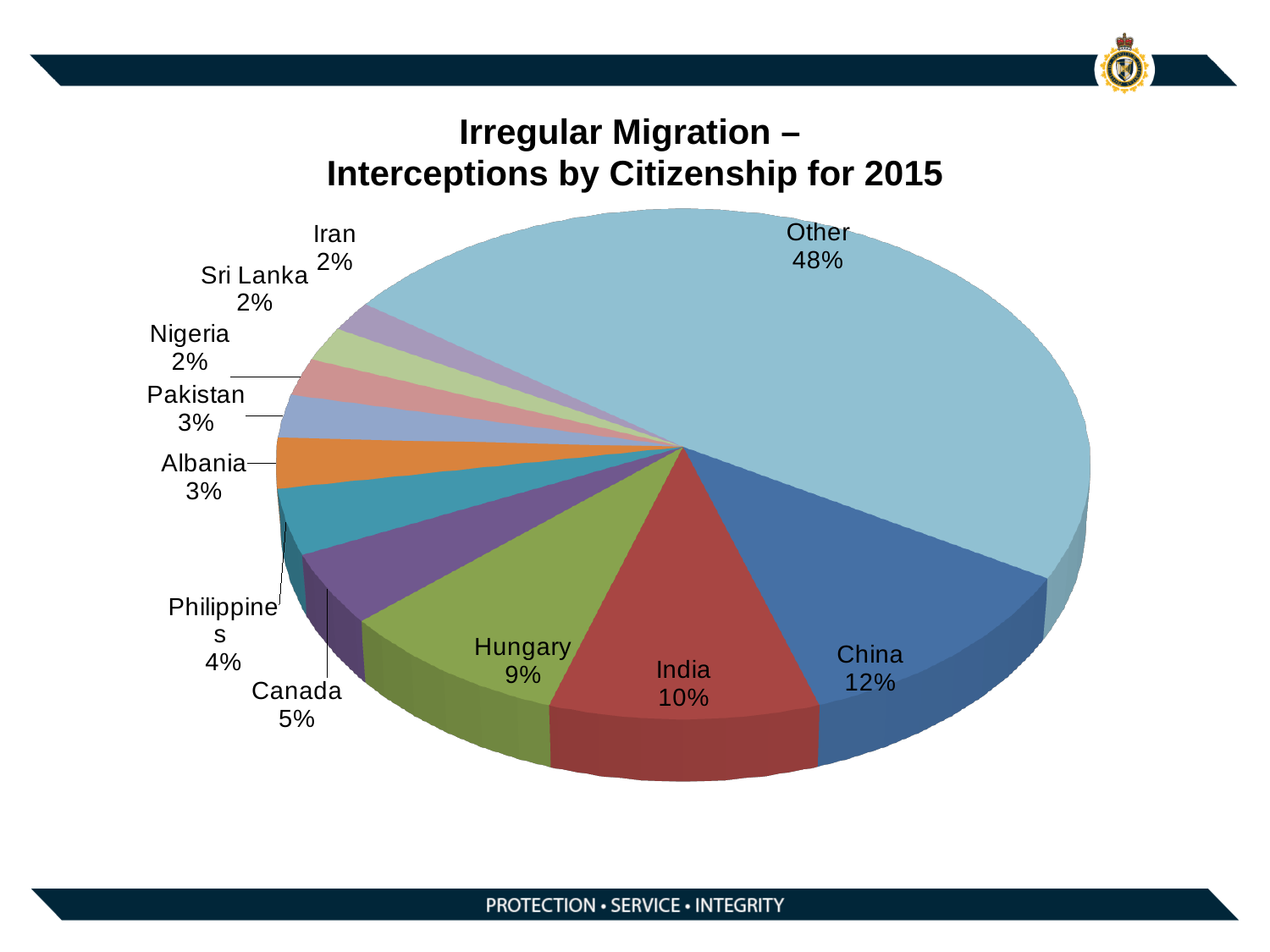
What is the difference in percentage points between China and India? 2 What percentage is shown for Albania? 3% What is the combined share of India and Hungary? 19% What type of chart is shown on the slide? Pie chart How many slices does the pie chart have? 11 What share of interceptions is attributed to China? 12% Which category has the largest slice of the pie? Other Which has a larger share, Hungary or Philippines? Hungary What is the title of the chart? Irregular Migration – Interceptions by Citizenship for 2015 What share of the pie is labelled Other? 48% What percentage of interceptions is shown for Hungary? 9% What share does Canada have in the pie chart? 5%